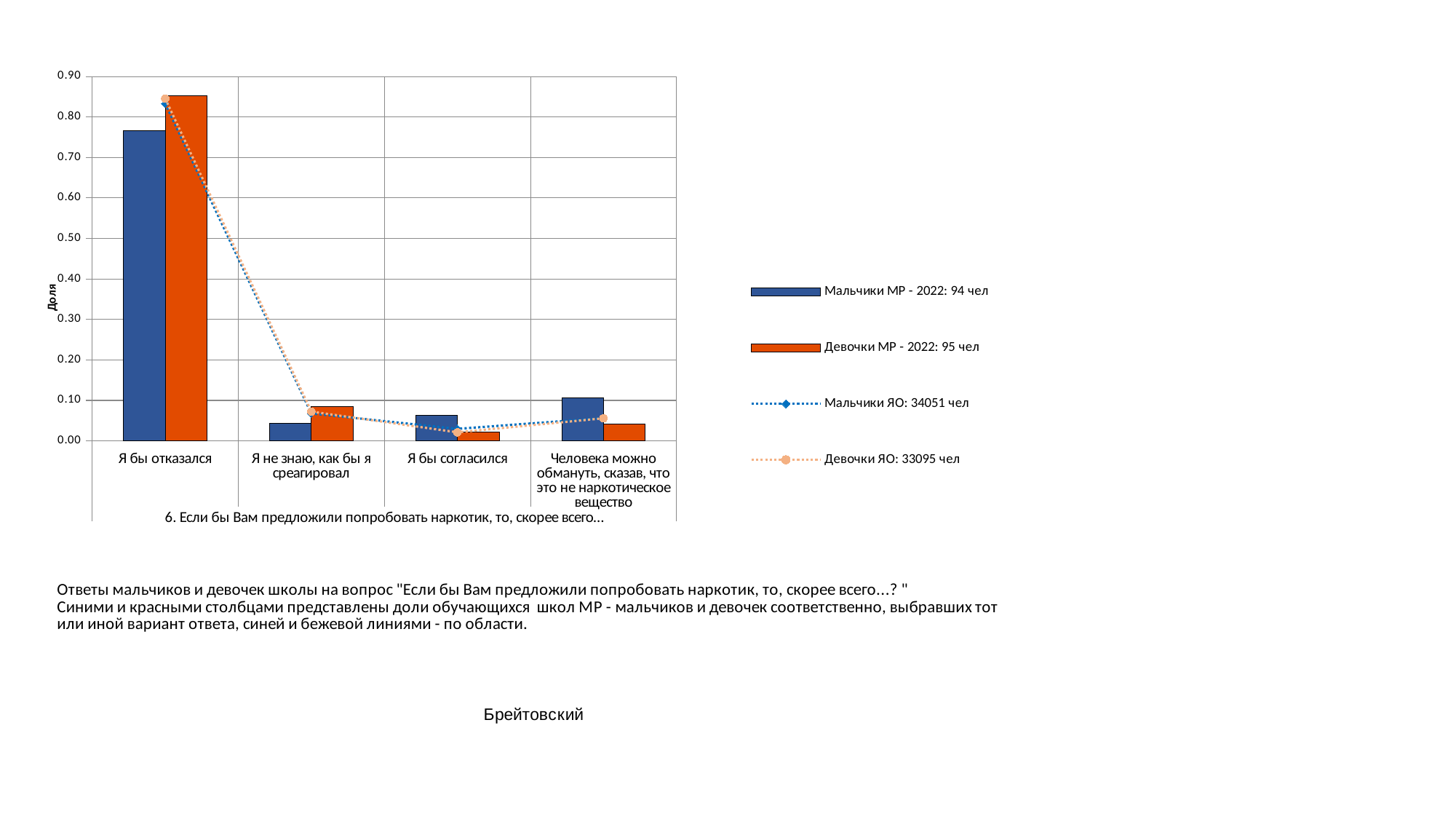
For the series Девочки МР - 2022: 95 чел, which category has the lowest value? Я бы согласился Is the value for Мальчики МР - 2022 in the category Я бы отказался greater or less than 0.70? greater Is the value for Мальчики МР - 2022 in the category Человека можно обмануть, сказав, что это не наркотическое вещество greater or less than 0.20? less How many answer categories are shown on the x axis? 4 What kind of chart is shown on the slide? bar and line chart For the series Мальчики МР - 2022: 94 чел, which category has the highest value? Я бы отказался How many series does the legend list? 4 Is the value for Девочки МР - 2022 in the category Я бы отказался greater or less than 0.80? greater In the category Я бы отказался, which is larger: the value for Мальчики МР - 2022 or for Девочки МР - 2022? Девочки МР - 2022 What is the title of the vertical axis? Доля In the category Человека можно обмануть, сказав, что это не наркотическое вещество, which is larger: the value for Мальчики МР - 2022 or for Девочки МР - 2022? Мальчики МР - 2022 Does the Мальчики ЯО line rise or fall from Я бы отказался to Я не знаю, как бы я среагировал? fall